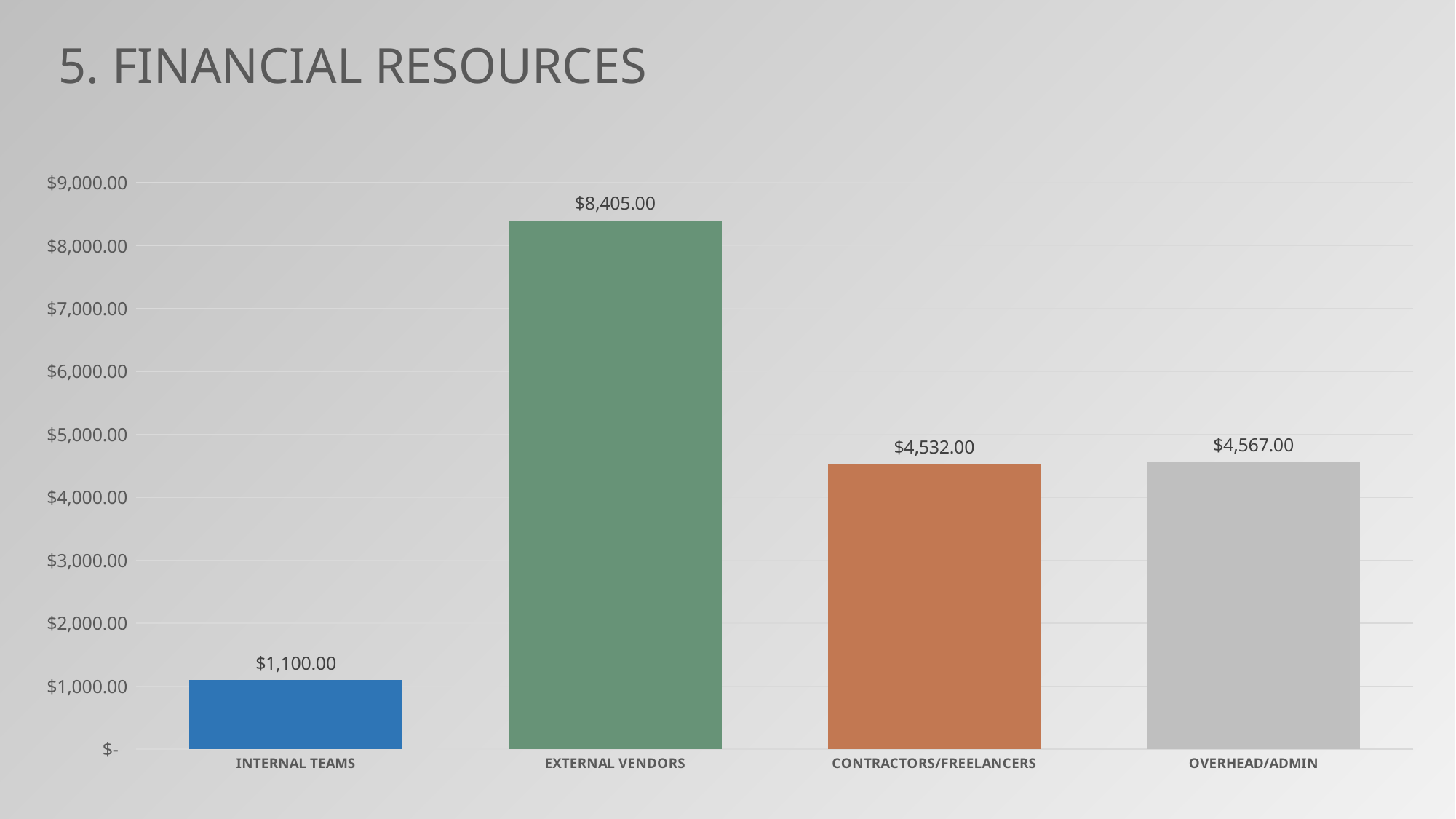
What is the difference between the values for External Vendors and Internal Teams? $7,305.00 What is the value for External Vendors? $8,405.00 How many categories are shown in the chart? 4 Is the value for Contractors/Freelancers greater or less than $5,000.00? less What is the difference between the values for Overhead/Admin and Contractors/Freelancers? $35.00 What kind of chart is shown on the slide? bar chart What is the value for Internal Teams? $1,100.00 Which is larger, the value for External Vendors or the value for Overhead/Admin? External Vendors What is the value for Contractors/Freelancers? $4,532.00 Which category has the highest value? External Vendors What is the value for Overhead/Admin? $4,567.00 Which category has the lowest value? Internal Teams